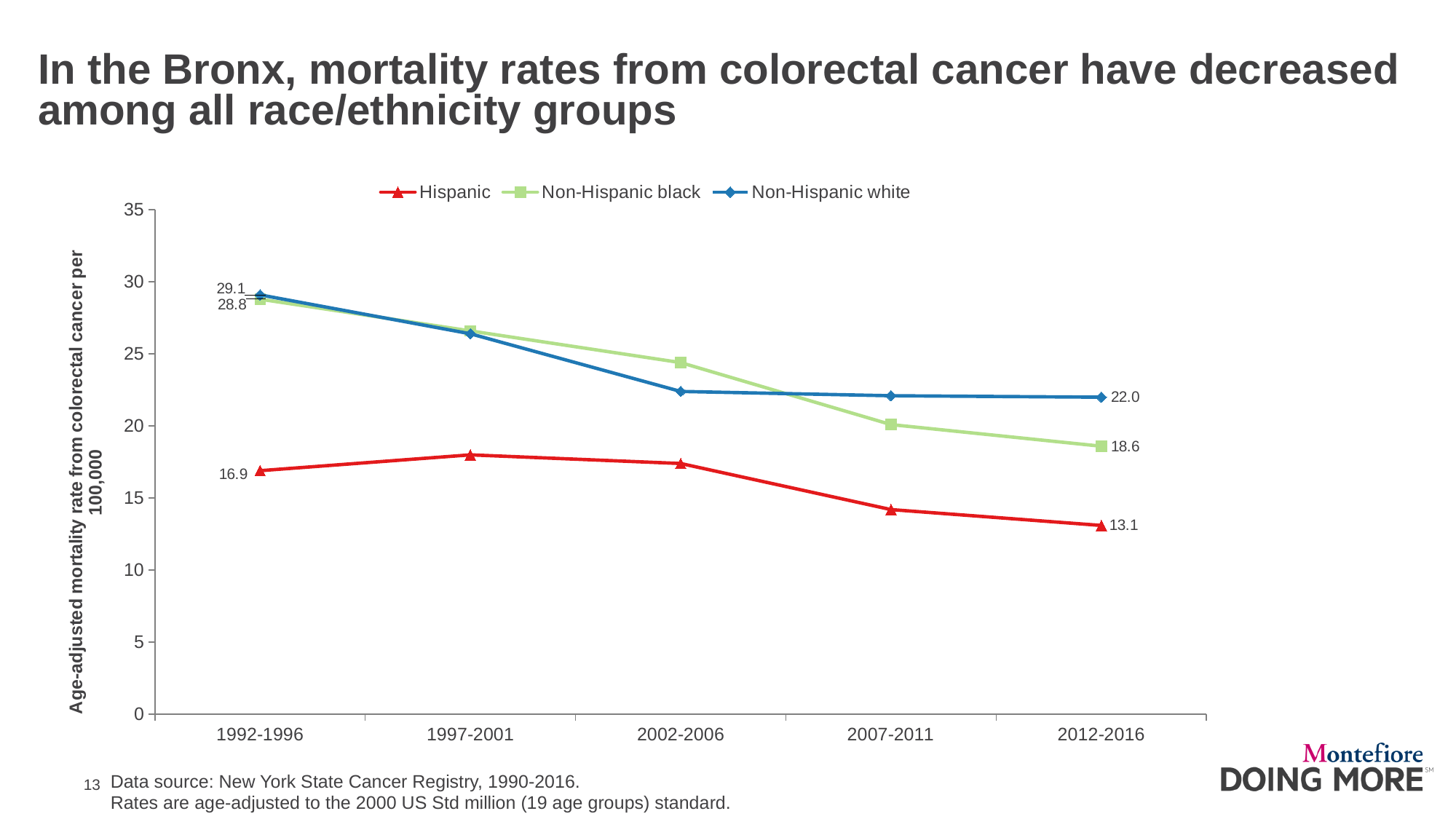
What is the mortality rate for Non-Hispanic black in 1992-1996? 28.8 How many time periods are shown on the x axis? 5 What is the mortality rate for Non-Hispanic white in 1992-1996? 29.1 Which is larger in 2012-2016, the rate for Non-Hispanic white or Non-Hispanic black? Non-Hispanic white How many series does the legend list? 3 What is the mortality rate for Non-Hispanic black in 2012-2016? 18.6 What is the mortality rate for Hispanic in 2012-2016? 13.1 Is the Non-Hispanic black mortality rate in 2002-2006 greater or less than 20? greater Does the Non-Hispanic white mortality rate rise or fall from 1992-1996 to 2012-2016? Fall Which group has the lowest mortality rate in 2012-2016? Hispanic What type of chart is shown on the slide? Line chart By how much did the Non-Hispanic white mortality rate decrease from 1992-1996 to 2012-2016? 7.1